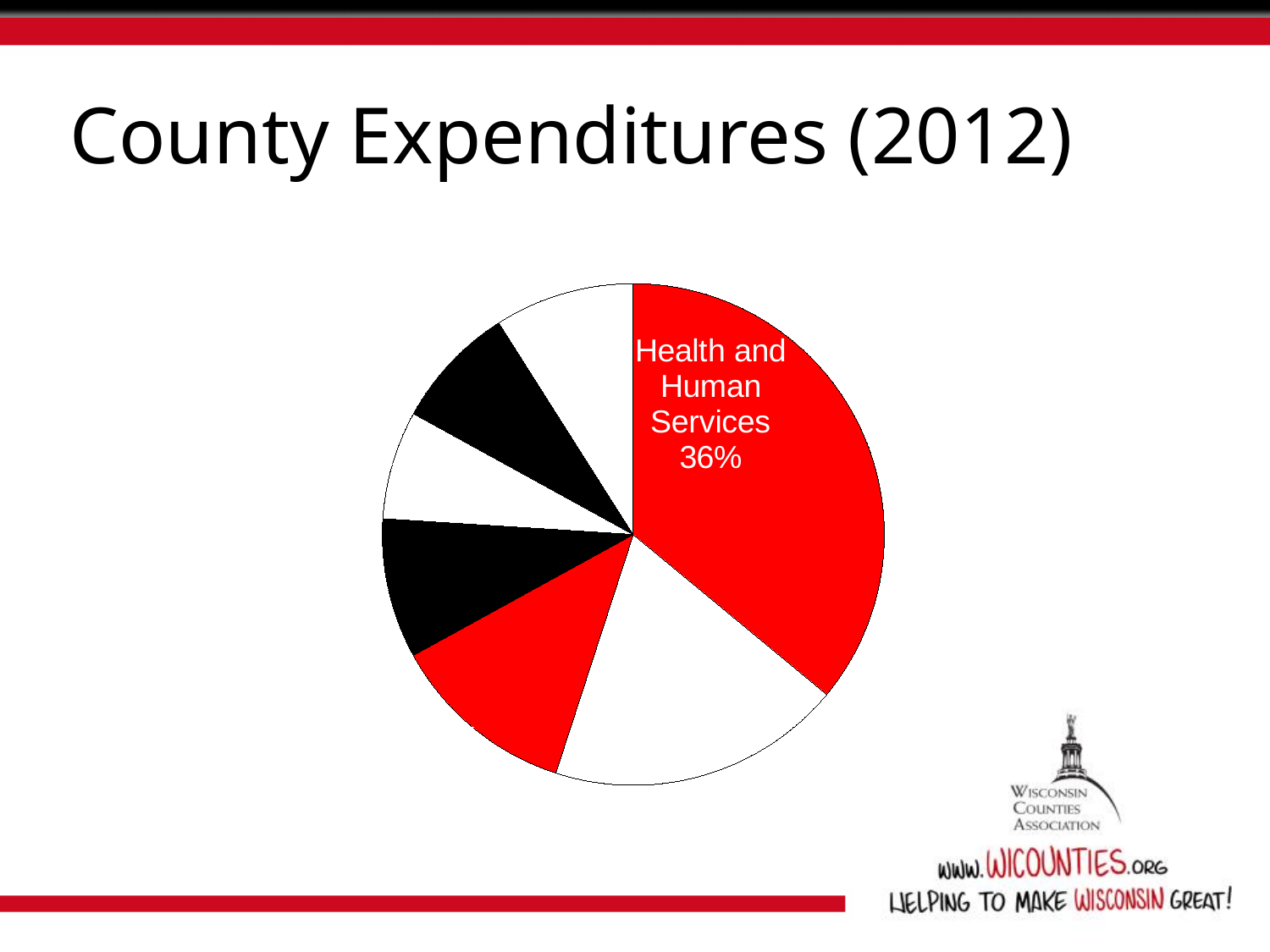
What colour is the Health and Human Services slice? red What kind of chart is shown on the slide? pie chart What is the title of the chart on the slide? County Expenditures (2012) Is the Health and Human Services slice greater or less than half of the pie? less Which slice is the only one with a printed label and percentage? Health and Human Services Which slice of the pie chart is the largest? Health and Human Services How many slices does the pie chart have? 7 What share of county expenditures goes to Health and Human Services? 36%